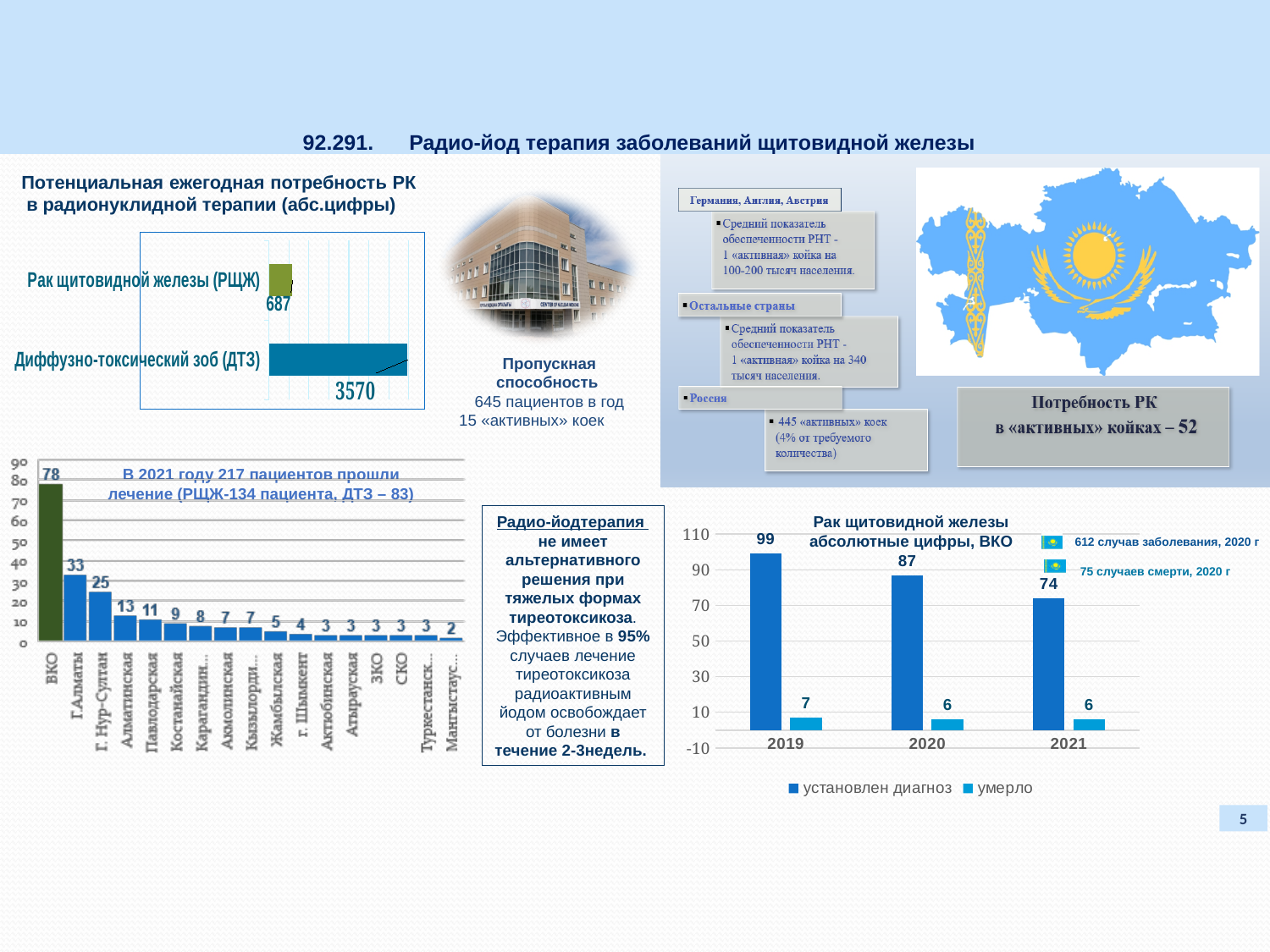
In the chart 'Рак щитовидной железы абсолютные цифры, ВКО', what is the value for умерло in 2019? 7 In the chart 'Рак щитовидной железы абсолютные цифры, ВКО', what is the value for установлен диагноз in 2020? 87 In the bottom-left chart of patients by region, which has a larger value, г. Нур-Султан or Алматинская? г. Нур-Султан In the chart 'Потенциальная ежегодная потребность РК в радионуклидной терапии', what is the value for Диффузно-токсический зоб (ДТЗ)? 3570 In the bottom-left chart of patients by region, what is the value for Павлодарская? 11 In the chart 'Рак щитовидной железы абсолютные цифры, ВКО', how does the установлен диагноз series change from 2019 to 2021? It falls What type of chart is 'Рак щитовидной железы абсолютные цифры, ВКО'? Bar chart In the bottom-left chart of patients by region, which region has the highest value? ВКО In the chart 'Потенциальная ежегодная потребность РК в радионуклидной терапии', what is the value for Рак щитовидной железы (РЩЖ)? 687 How many series does the legend of the chart 'Рак щитовидной железы абсолютные цифры, ВКО' list? 2 In the bottom-left chart of patients by region, what is the value for Г.Алматы? 33 In the chart 'Потенциальная ежегодная потребность РК в радионуклидной терапии', what is the difference between the ДТЗ and РЩЖ values? 2883